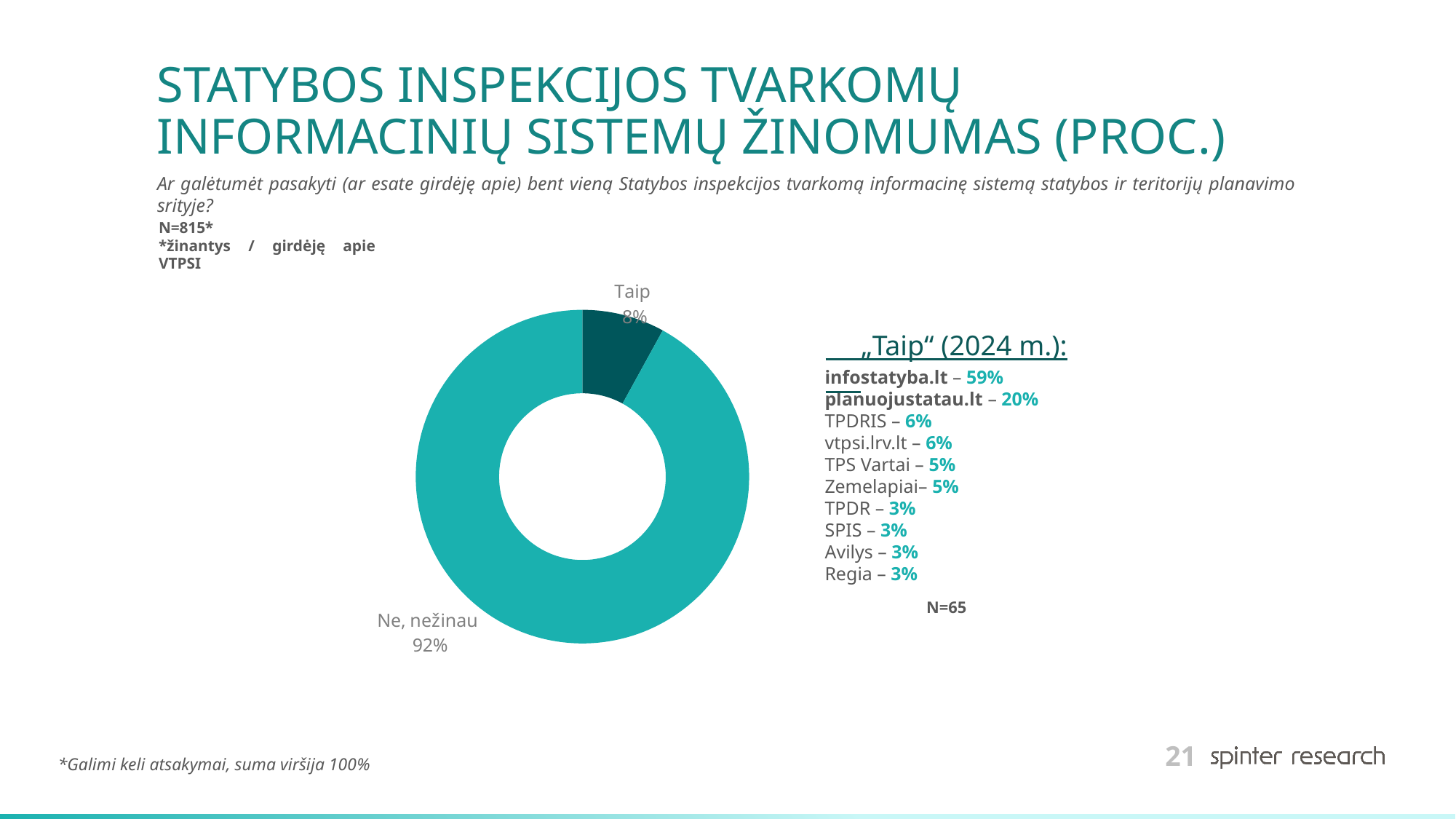
What is the difference between the "Ne, nežinau" and "Taip" values in the donut chart? 84 percentage points Which slice of the donut chart is the largest? Ne, nežinau Which slice of the donut chart is the smallest? Taip Which slice of the donut chart is drawn in the darker teal colour? Taip What is the value for "Ne, nežinau" in the donut chart? 92% How many slices does the donut chart have? 2 What is the total of the two slices shown in the donut chart? 100% Which is larger in the donut chart, "Taip" or "Ne, nežinau"? Ne, nežinau What kind of chart is shown on the slide? Donut (pie) chart What is the value for "Taip" in the donut chart? 8% What is the sample size (N) stated for the donut chart? N=815* What share of the donut chart does the "Taip" slice represent? 8%